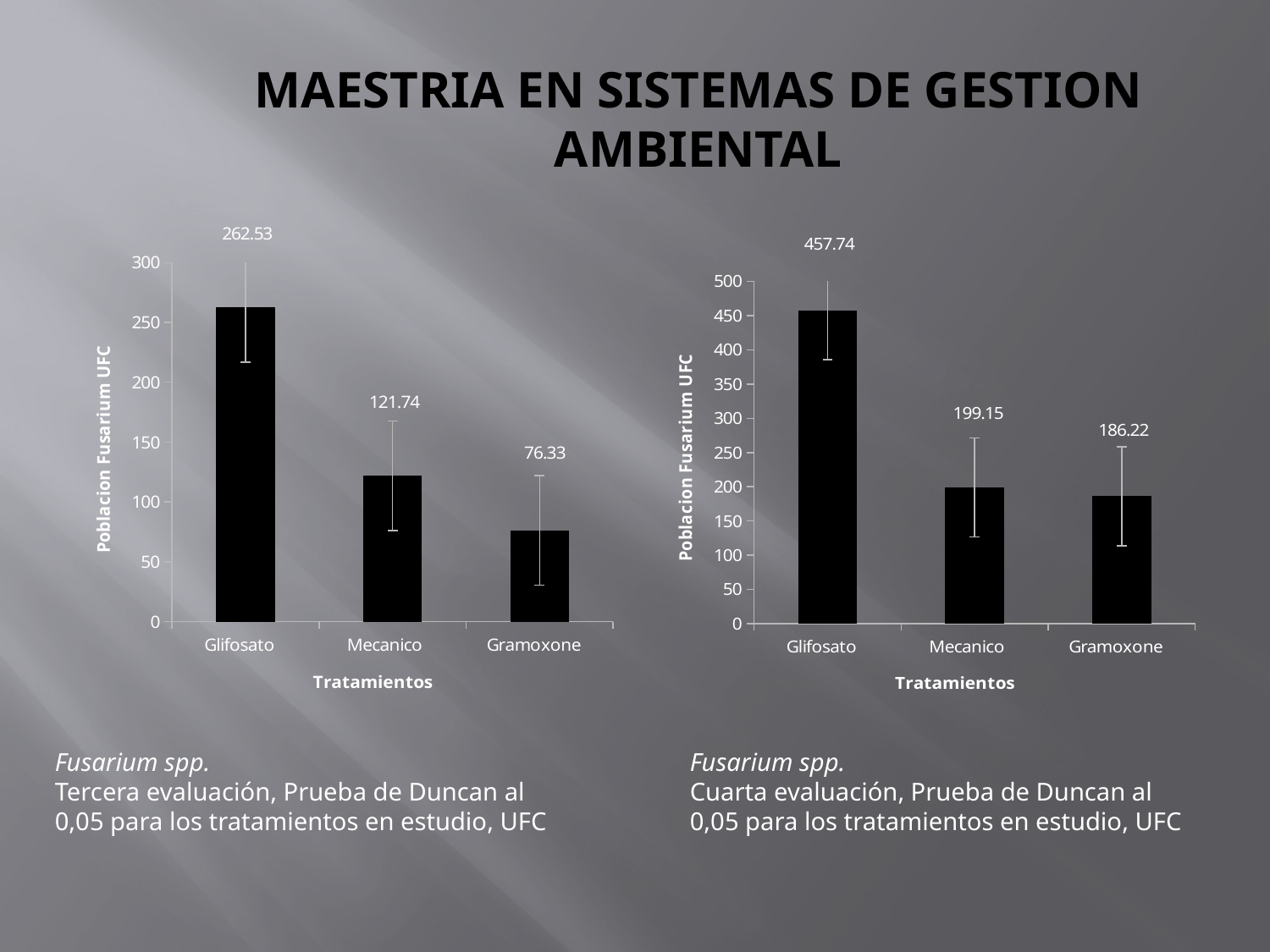
In the right chart (Cuarta evaluación), which treatment has the lowest Fusarium population? Gramoxone In the left chart (Tercera evaluación), which treatment has the highest Fusarium population? Glifosato In the right chart (Cuarta evaluación), which is larger, the value for Mecanico or the value for Gramoxone? Mecanico What is the y-axis title of the left chart (Tercera evaluación)? Poblacion Fusarium UFC How many treatments are shown on the x axis of the left chart (Tercera evaluación)? 3 In the left chart (Tercera evaluación), what is the difference between the values for Glifosato and Mecanico? 140.79 In the right chart (Cuarta evaluación), what is the value for Glifosato? 457.74 What kind of chart is the right chart (Cuarta evaluación)? Bar chart In the left chart (Tercera evaluación), what is the value for Gramoxone? 76.33 In the left chart (Tercera evaluación), what is the value for Glifosato? 262.53 In the right chart (Cuarta evaluación), what is the difference between the values for Mecanico and Gramoxone? 12.93 In the right chart (Cuarta evaluación), what is the value for Mecanico? 199.15